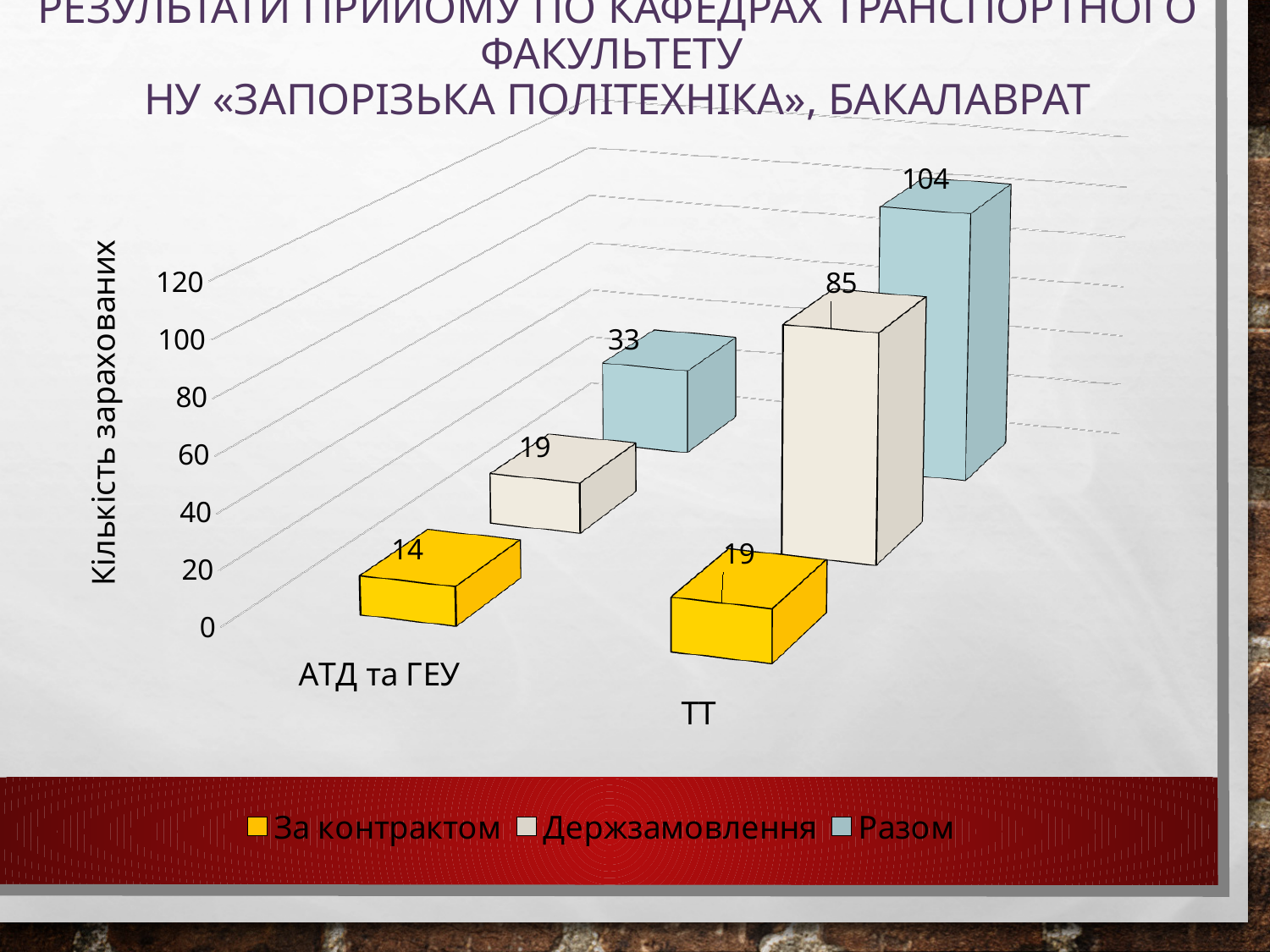
What kind of chart is shown on the slide? Bar chart Which category has the highest Разом value? ТТ How many categories are shown on the x axis? 2 What is the value for За контрактом in the АТД та ГЕУ category? 14 What is the label of the vertical axis? Кількість зарахованих What is the value for Разом in the АТД та ГЕУ category? 33 What is the value for Разом in the ТТ category? 104 Which category has the lowest Держзамовлення value? АТД та ГЕУ How many series does the legend list? 3 Which is larger: За контрактом for ТТ or За контрактом for АТД та ГЕУ? ТТ What is the difference between the Держзамовлення values for ТТ and АТД та ГЕУ? 66 What is the value for Держзамовлення in the ТТ category? 85